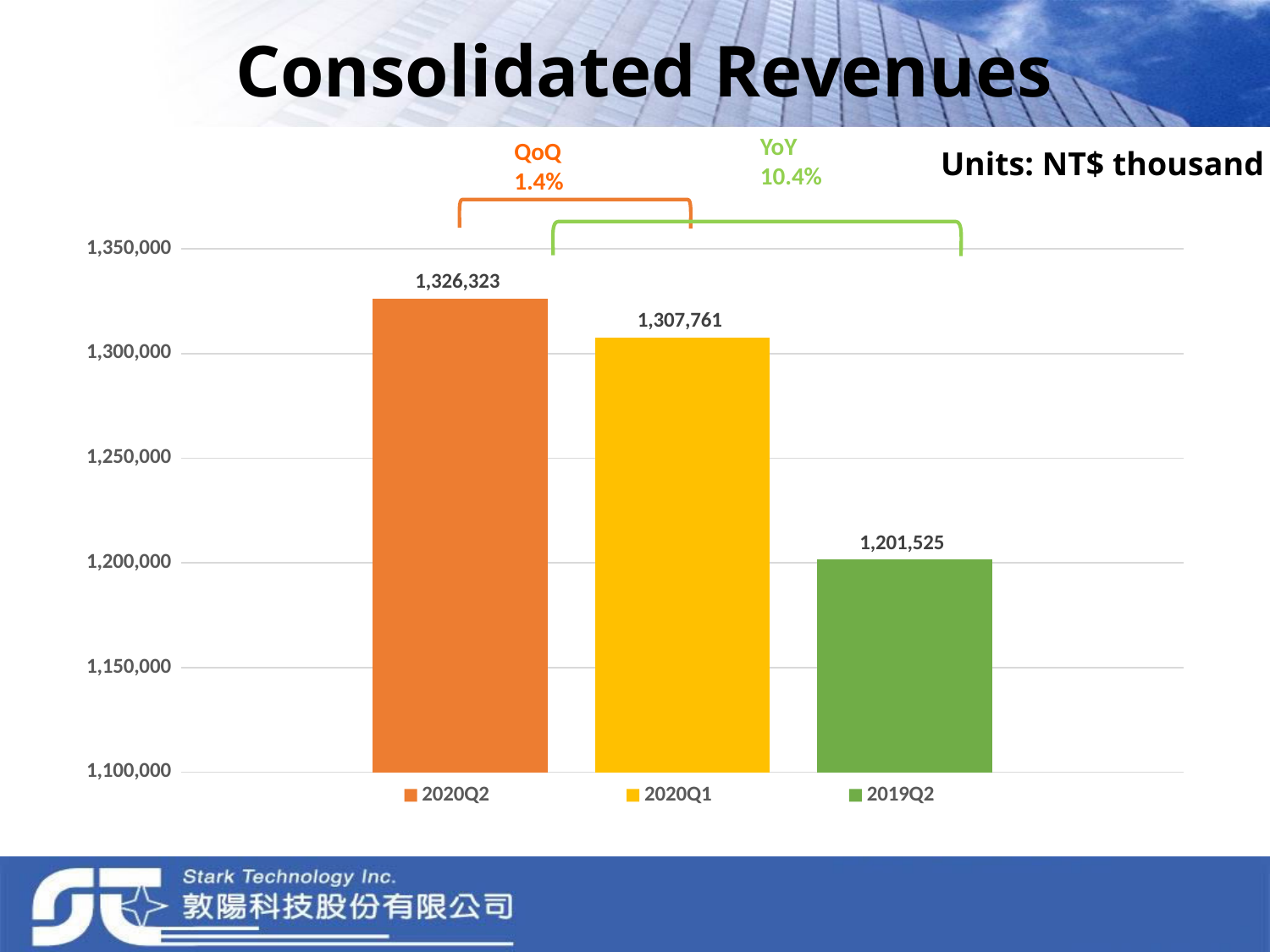
What is the consolidated revenue for 2019Q2? 1,201,525 What kind of chart is shown on the slide? Bar chart What units are the revenues shown in? NT$ thousand What is the difference between the 2020Q2 and 2019Q2 revenues? 124,798 What is the difference between the 2020Q2 and 2020Q1 revenues? 18,562 Which is larger, the revenue for 2020Q1 or for 2019Q2? 2020Q1 Which quarter has the lowest consolidated revenue? 2019Q2 Which quarter has the highest consolidated revenue? 2020Q2 What is the consolidated revenue for 2020Q2? 1,326,323 How many bars are plotted in the chart? 3 What is the consolidated revenue for 2020Q1? 1,307,761 How many entries does the legend list? 3